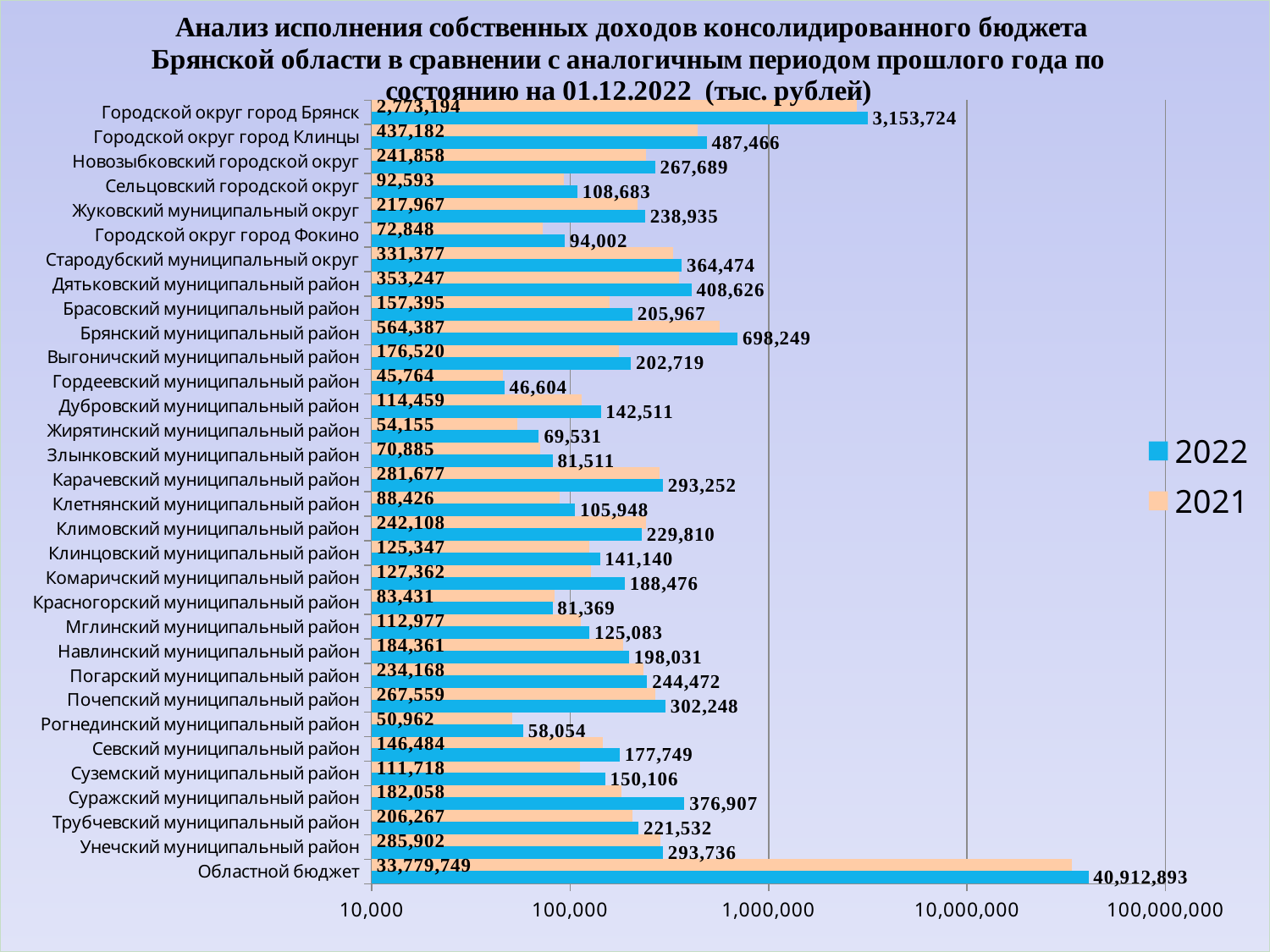
How many categories are shown on the chart? 32 Which category has the lowest 2022 value? Гордеевский муниципальный район What is the difference between the 2022 and 2021 values for Суражский муниципальный район? 194,849 What is the 2021 value for Городской округ город Брянск? 2,773,194 Is the 2022 value for Гордеевский муниципальный район greater or less than 100,000? less What is the 2022 value for Областной бюджет? 40,912,893 How many series does the legend list? 2 Which category has the highest 2022 value? Областной бюджет For Климовский муниципальный район, which year has the larger value, 2022 or 2021? 2021 What is the difference between the 2022 and 2021 values for Областной бюджет? 7,133,144 What kind of chart is shown on the slide? bar chart What is the 2022 value for Брянский муниципальный район? 698,249